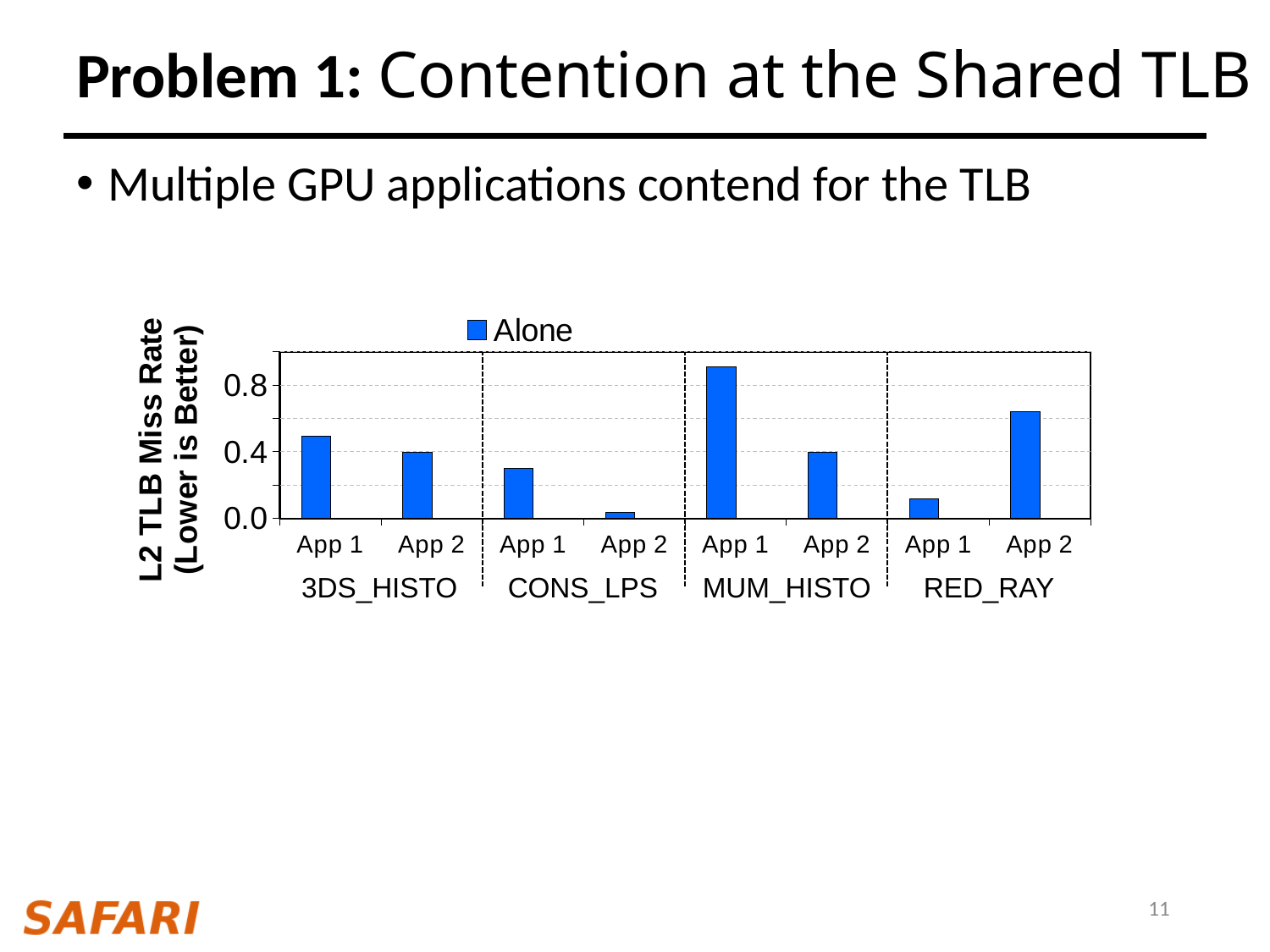
Which bar has the lowest L2 TLB miss rate? App 2 in CONS_LPS What kind of chart is shown on the slide? bar chart Is the L2 TLB miss rate for App 2 in RED_RAY greater or less than 0.4? greater Is the L2 TLB miss rate for App 1 in MUM_HISTO greater or less than 0.8? greater Is the L2 TLB miss rate for App 1 in RED_RAY greater or less than 0.4? less Which bar has the highest L2 TLB miss rate? App 1 in MUM_HISTO How many bars are plotted in the chart? 8 How many workload groups are shown along the x axis? 4 In RED_RAY, which has the higher L2 TLB miss rate, App 1 or App 2? App 2 What is the name of the series shown in the legend? Alone In CONS_LPS, which has the higher L2 TLB miss rate, App 1 or App 2? App 1 How many series does the legend list? 1